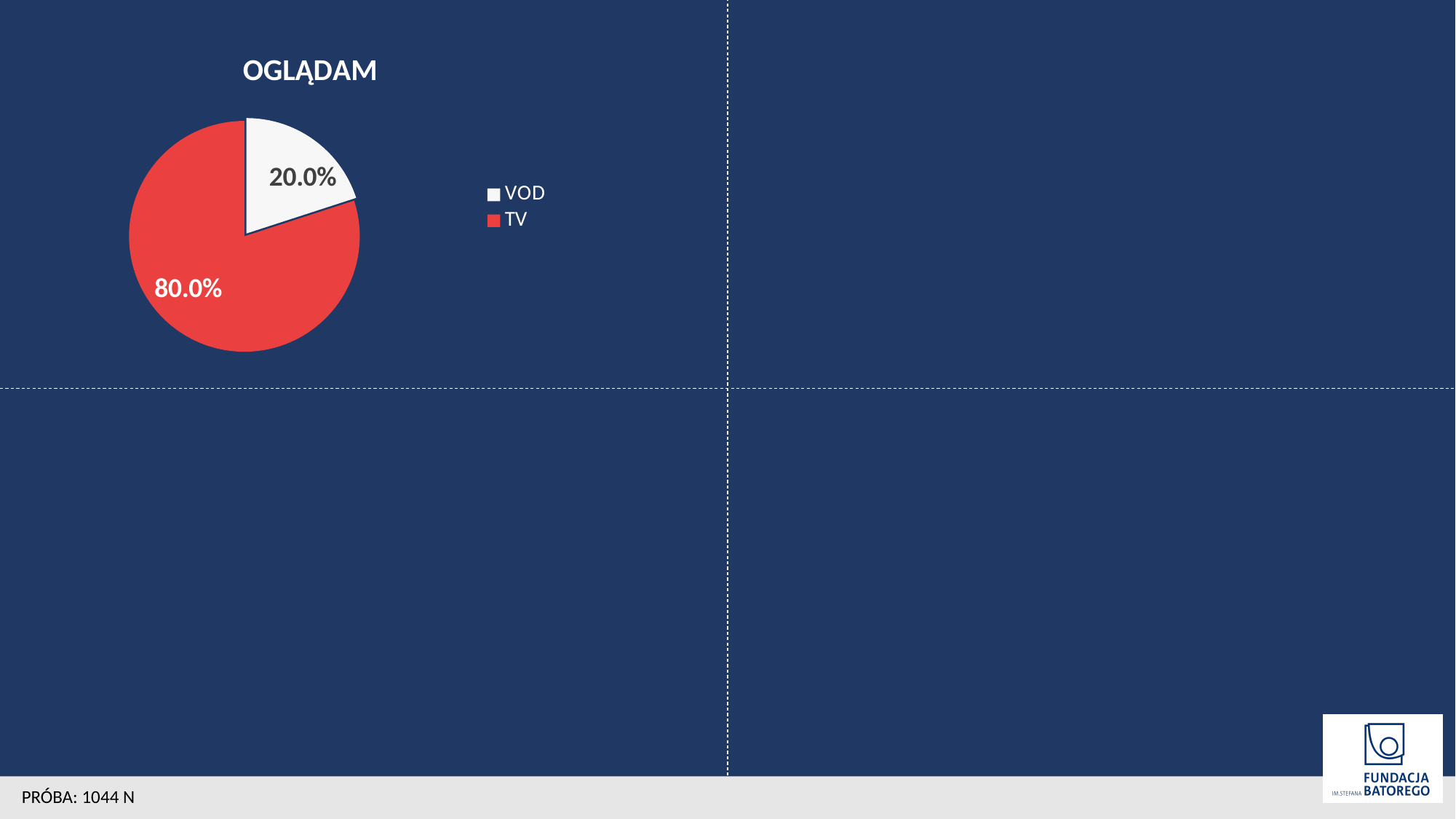
How many entries does the legend list? 2 What colour is the TV slice? red What share of the pie does TV take? 80.0% Which category has the smallest slice of the pie? VOD What is the title of the chart? OGLĄDAM What share of the pie does VOD take? 20.0% How many categories does the pie chart show? 2 What is the difference in percentage points between the TV and VOD slices? 60.0% What kind of chart is shown on the slide? pie chart Which is larger, the VOD slice or the TV slice? TV Which category has the largest slice of the pie? TV